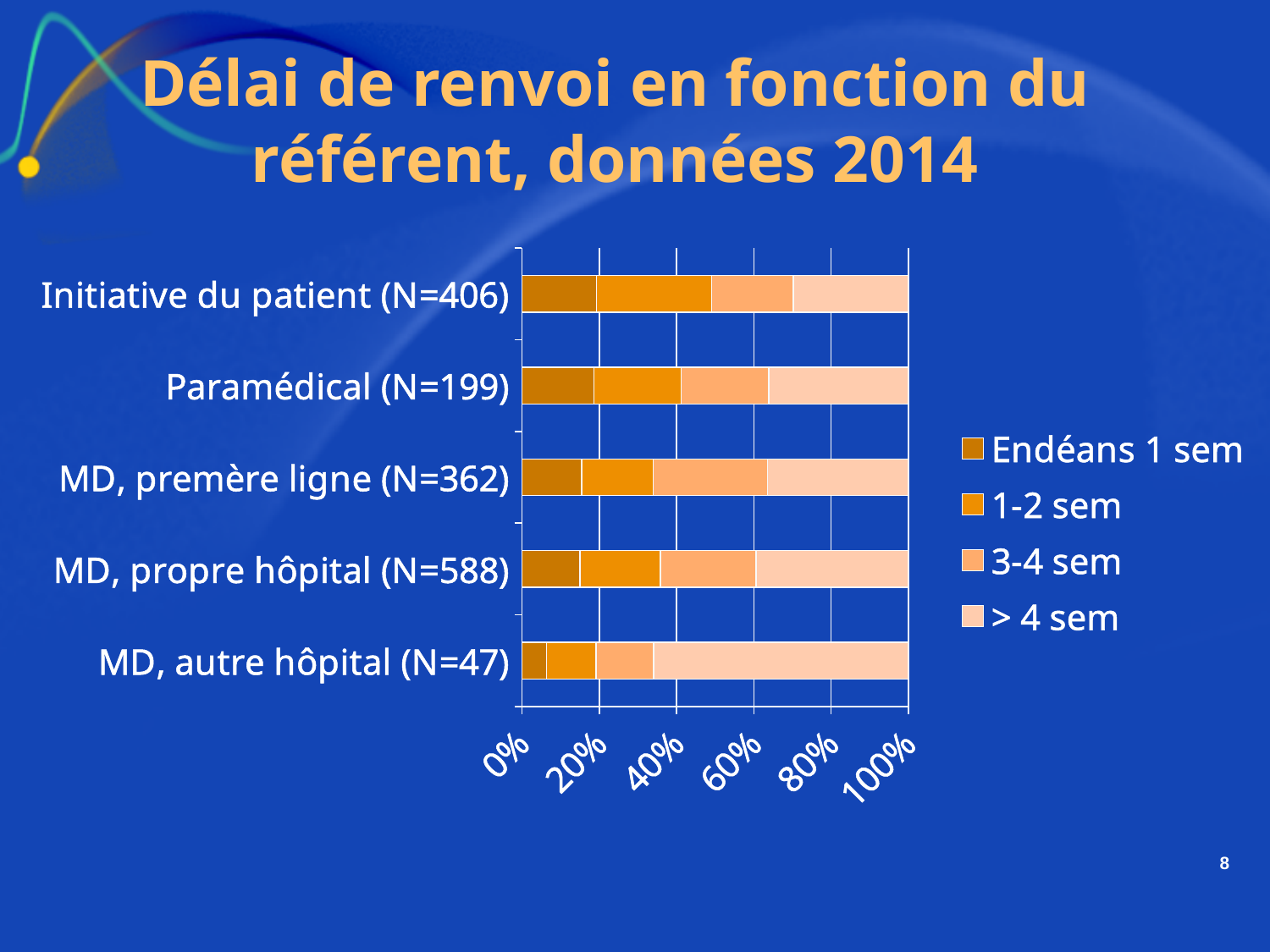
Which legend entry represents the lightest-coloured segment? > 4 sem Which has a larger '> 4 sem' share: MD, autre hôpital (N=47) or Initiative du patient (N=406)? MD, autre hôpital (N=47) Is the 'Endéans 1 sem' share for MD, autre hôpital (N=47) greater or less than 20%? less How many referrer categories are plotted on the chart? 5 Is the '> 4 sem' share for Initiative du patient (N=406) greater or less than 40%? less What kind of chart is shown on the slide? Stacked bar chart Is the '> 4 sem' share for MD, autre hôpital (N=47) greater or less than 60%? greater Which has a larger 'Endéans 1 sem' share: Initiative du patient (N=406) or MD, autre hôpital (N=47)? Initiative du patient (N=406) What is the title of the chart on the slide? Délai de renvoi en fonction du référent, données 2014 How many series does the legend list? 4 Which category has the smallest share of 'Endéans 1 sem'? MD, autre hôpital (N=47) Which category has the largest share of '> 4 sem'? MD, autre hôpital (N=47)